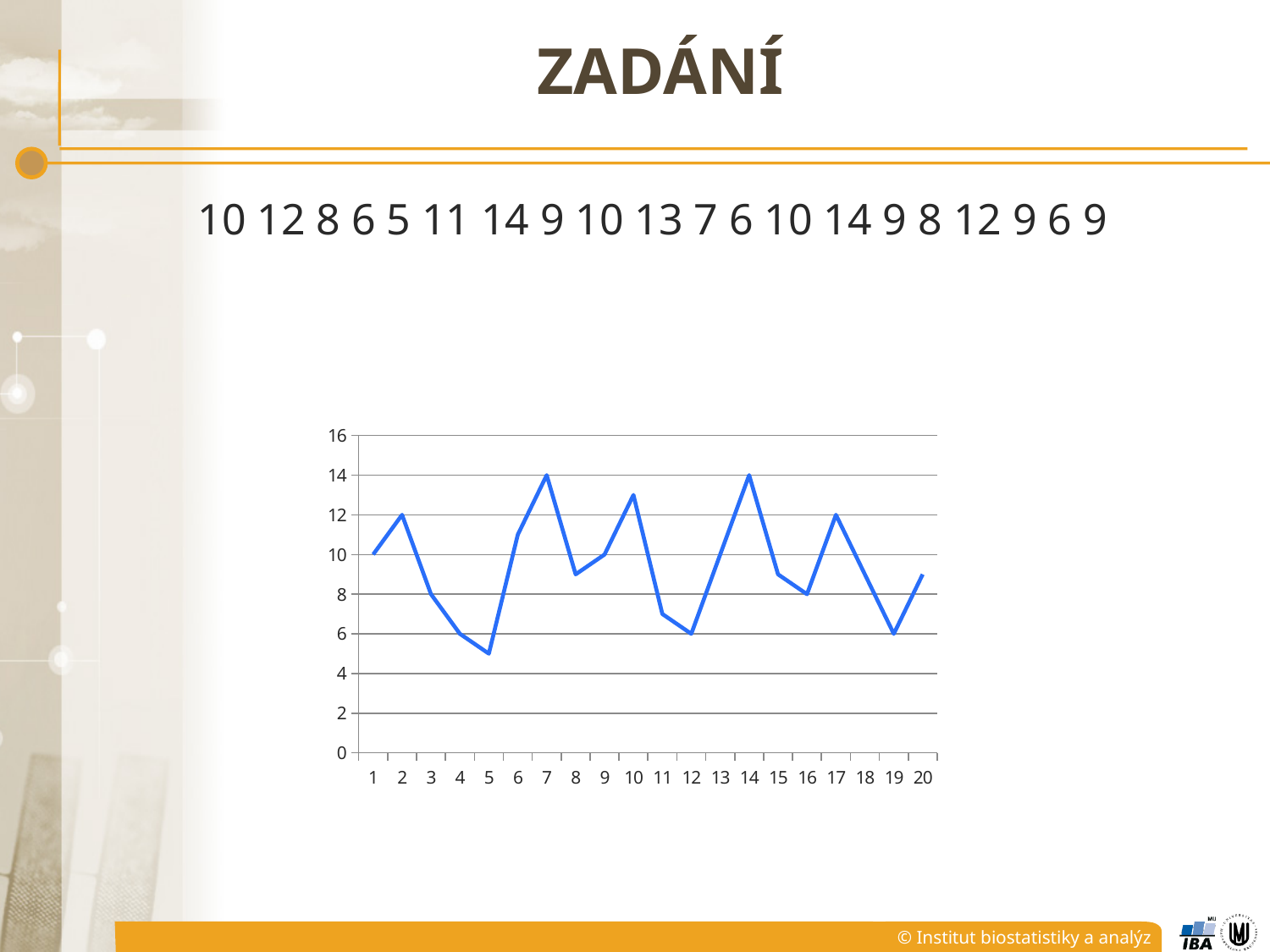
What is the value at point 7 on the chart? 14 What is the value at point 1 on the chart? 10 Is the value at point 10 greater or less than 12? greater What is the value at point 2 on the chart? 12 What kind of chart is shown on the slide? line chart What is the value at point 5 on the chart? 5 What is the difference between the value at point 7 and the value at point 5? 9 Which has the larger value, point 2 or point 3? point 2 What is the value at point 19 on the chart? 6 At which point does the line reach its lowest value? 5 How many points are plotted along the x axis of the chart? 20 Does the line rise or fall from point 2 to point 5? fall